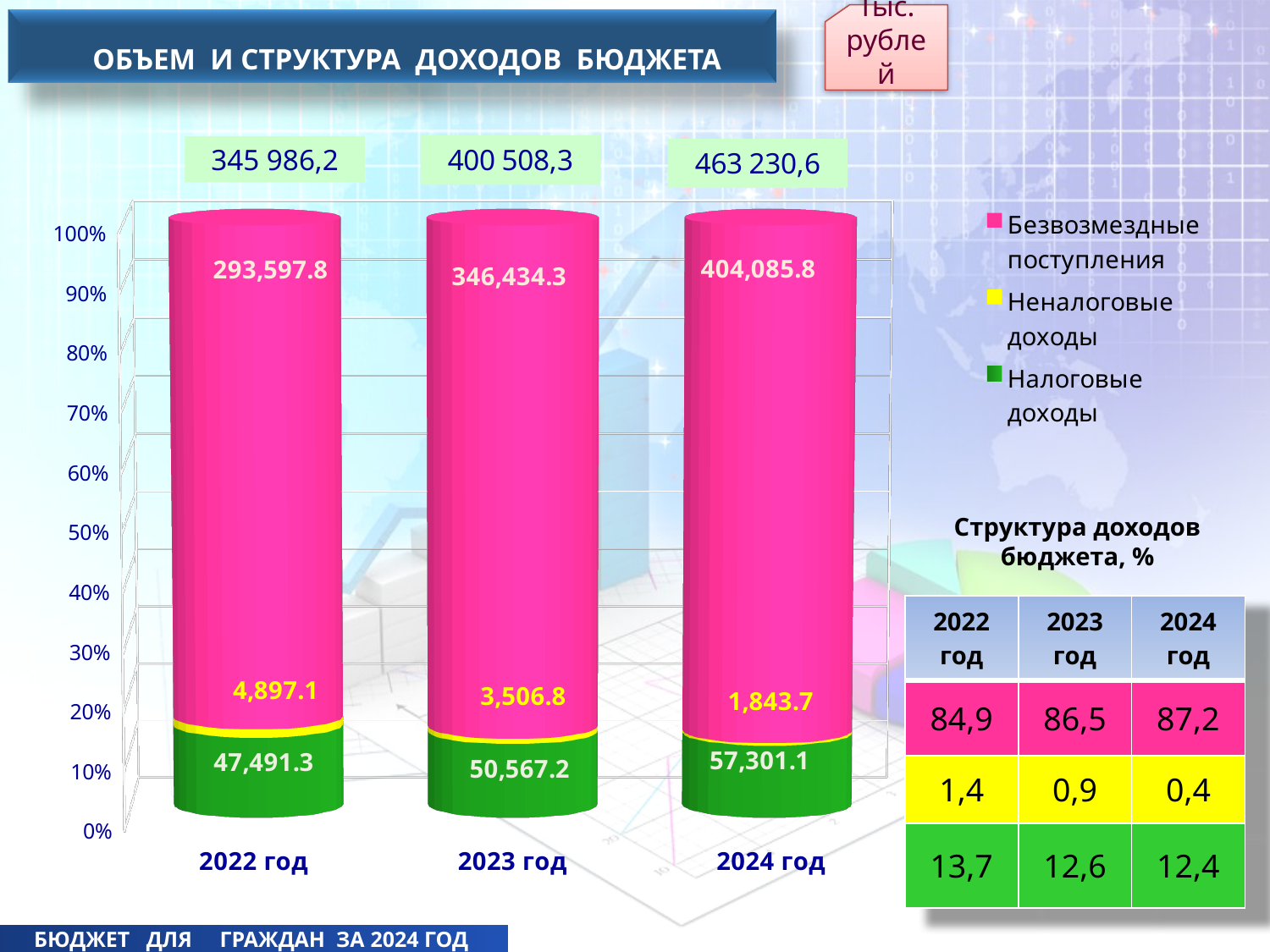
What is the value of Налоговые доходы for 2022 год? 47,491.3 Which is larger: Безвозмездные поступления in 2022 год or in 2023 год? 2023 год How many series does the chart legend list? 3 What is the difference between Налоговые доходы in 2024 год and 2023 год? 6,733.9 How many years (categories) are shown on the x axis of the chart? 3 What is the value of Безвозмездные поступления for 2024 год? 404,085.8 What is the value of Неналоговые доходы for 2023 год? 3,506.8 Do the values for Налоговые доходы rise or fall from 2022 год to 2024 год? Rise What kind of chart is shown on the slide? Stacked bar chart What is the value of Налоговые доходы for 2024 год? 57,301.1 Which year has the highest value for Неналоговые доходы? 2022 год Which year has the lowest value for Налоговые доходы? 2022 год